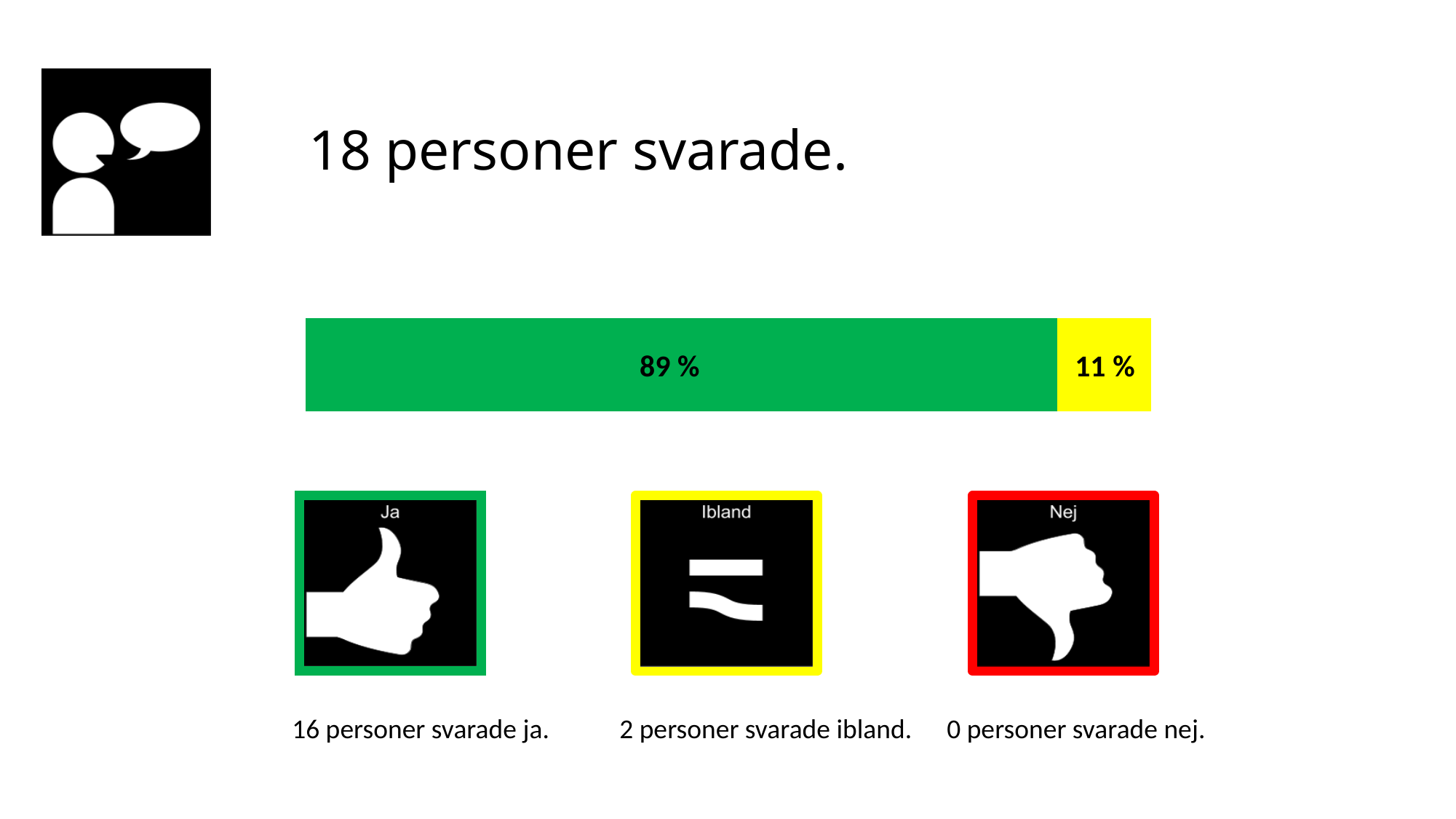
Which segment of the bar has the smallest value? yellow (11 %) What percentage is printed on the yellow segment of the bar? 11 % What is the total of the two segments in the stacked bar? 100 % What percentage is printed on the green segment of the bar? 89 % Which segment of the bar has the largest value? green (89 %) How many segments does the stacked bar have? 2 Which segment of the bar is larger, the green one or the yellow one? green According to the slide, how many people answered in total? 18 What is the difference between the green segment's value and the yellow segment's value? 78 % What kind of chart is shown on the slide? bar chart What colour is the segment of the bar that matches the 'Ja' icon's frame? green